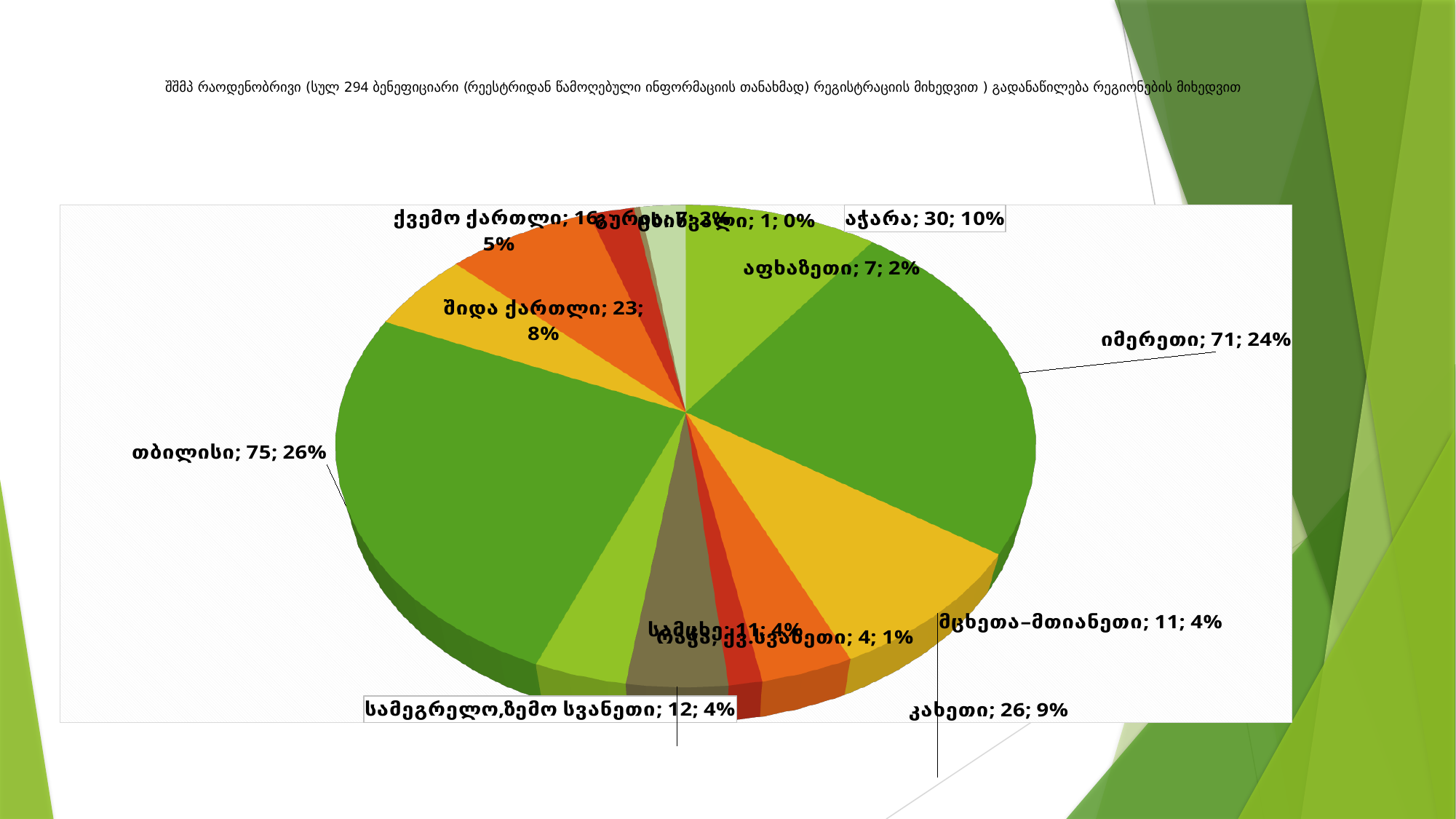
Which is larger, the value for აჭარა or the value for კახეთი? აჭარა What is the value for აჭარა? 30 Which region has the largest slice of the pie? თბილისი What is the value for აფხაზეთი? 7 What share of the pie does თბილისი represent? 26% What kind of chart is shown on the slide? pie chart What is the difference between the values for თბილისი and იმერეთი? 4 What is the value for იმერეთი? 71 What share of the pie does იმერეთი represent? 24% What is the value for კახეთი? 26 What is the value for შიდა ქართლი? 23 What is the value for თბილისი? 75